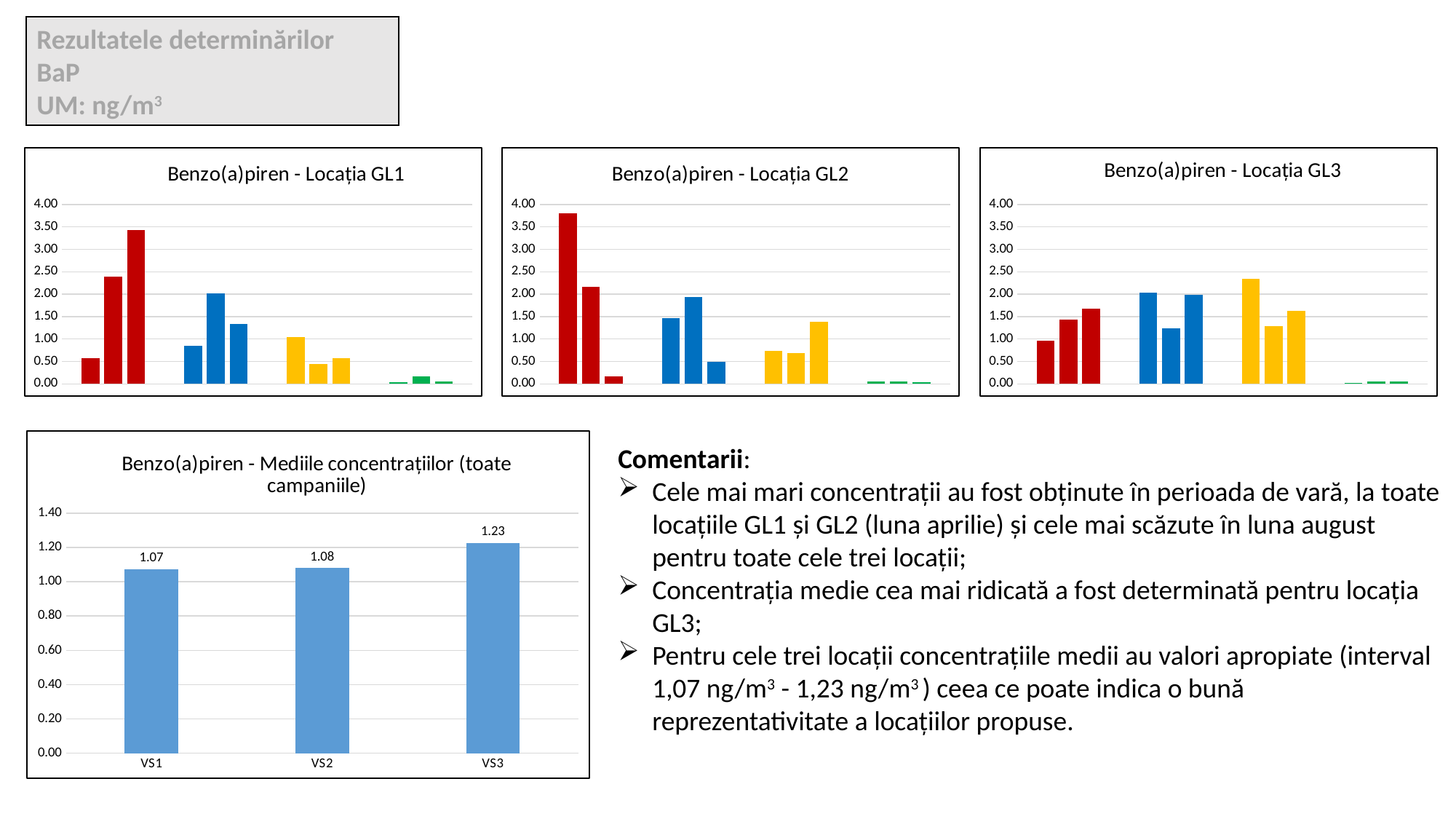
In the chart titled "Benzo(a)piren - Mediile concentrațiilor (toate campaniile)", which category has the lowest value? VS1 In the chart titled "Benzo(a)piren - Mediile concentrațiilor (toate campaniile)", what is the value for VS3? 1.23 What is the title of the top-right chart on the slide? Benzo(a)piren - Locația GL3 In the chart titled "Benzo(a)piren - Mediile concentrațiilor (toate campaniile)", which is larger, the value for VS3 or the value for VS2? VS3 In the chart titled "Benzo(a)piren - Mediile concentrațiilor (toate campaniile)", what is the value for VS1? 1.07 In the chart titled "Benzo(a)piren - Mediile concentrațiilor (toate campaniile)", what is the value for VS2? 1.08 In the chart titled "Benzo(a)piren - Mediile concentrațiilor (toate campaniile)", what is the difference between the values for VS3 and VS1? 0.16 What kind of chart is the chart titled "Benzo(a)piren - Locația GL2"? bar chart In the chart titled "Benzo(a)piren - Mediile concentrațiilor (toate campaniile)", which category has the highest value? VS3 In the chart titled "Benzo(a)piren - Mediile concentrațiilor (toate campaniile)", is the value for VS3 greater or less than 1.20? greater In the chart titled "Benzo(a)piren - Mediile concentrațiilor (toate campaniile)", how many categories are shown on the x axis? 3 In the chart titled "Benzo(a)piren - Mediile concentrațiilor (toate campaniile)", what is the difference between the values for VS3 and VS2? 0.15